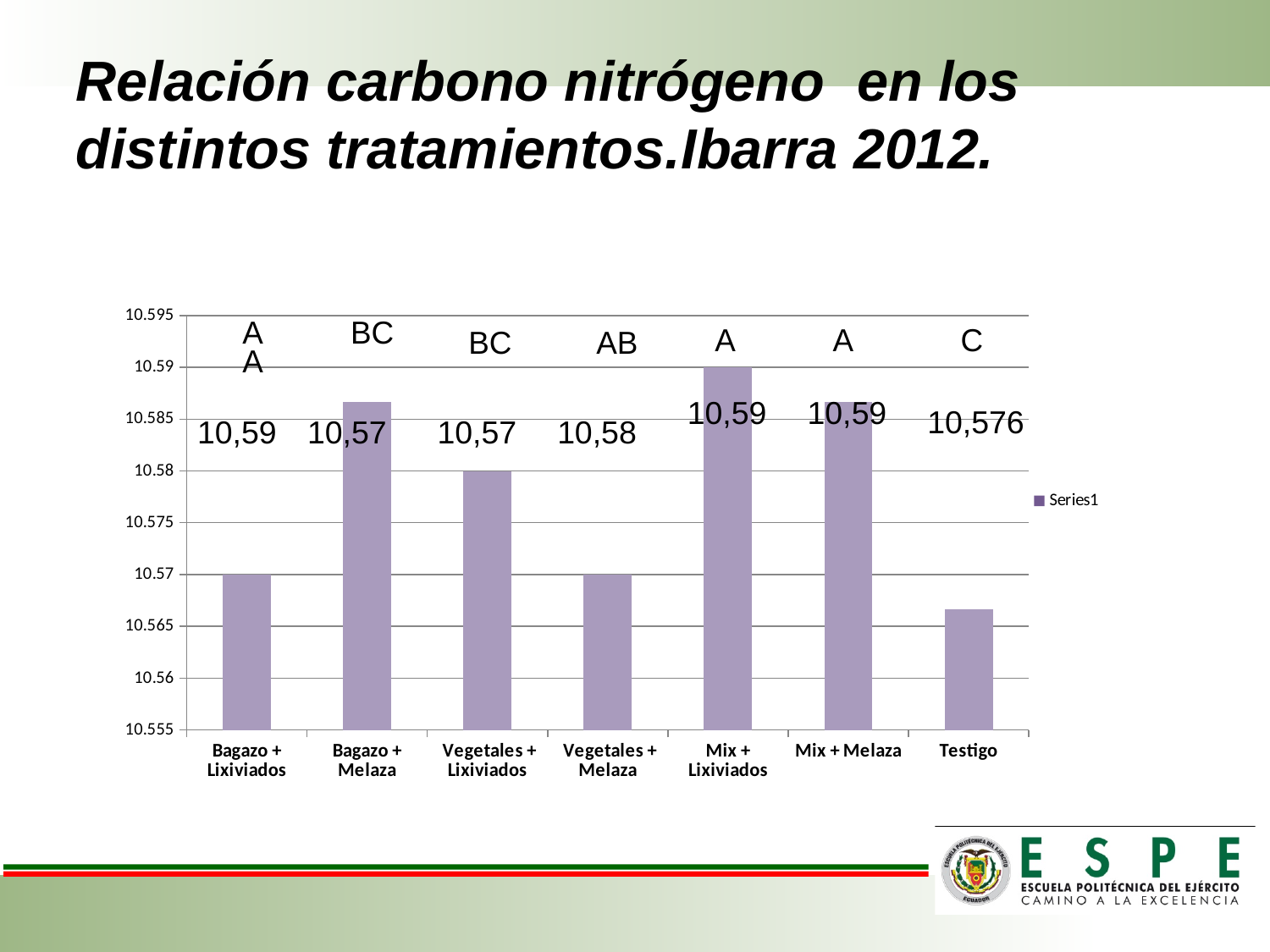
Is the value for Vegetales + Melaza greater or less than 10.575? less Is the value for Mix + Melaza greater or less than 10.58? greater What is the name of the series shown in the chart legend? Series1 What kind of chart is shown on the slide? bar chart What value is labelled for Mix + Lixiviados in the chart? 10,59 Is the value for Bagazo + Melaza greater or less than 10.58? greater Which has the taller bar, Mix + Melaza or Vegetales + Lixiviados? Mix + Melaza How many series does the chart legend list? 1 Which treatment has the lowest bar in the chart? Testigo Which treatment has the highest bar in the chart? Mix + Lixiviados How many treatment categories are shown on the x axis of the chart? 7